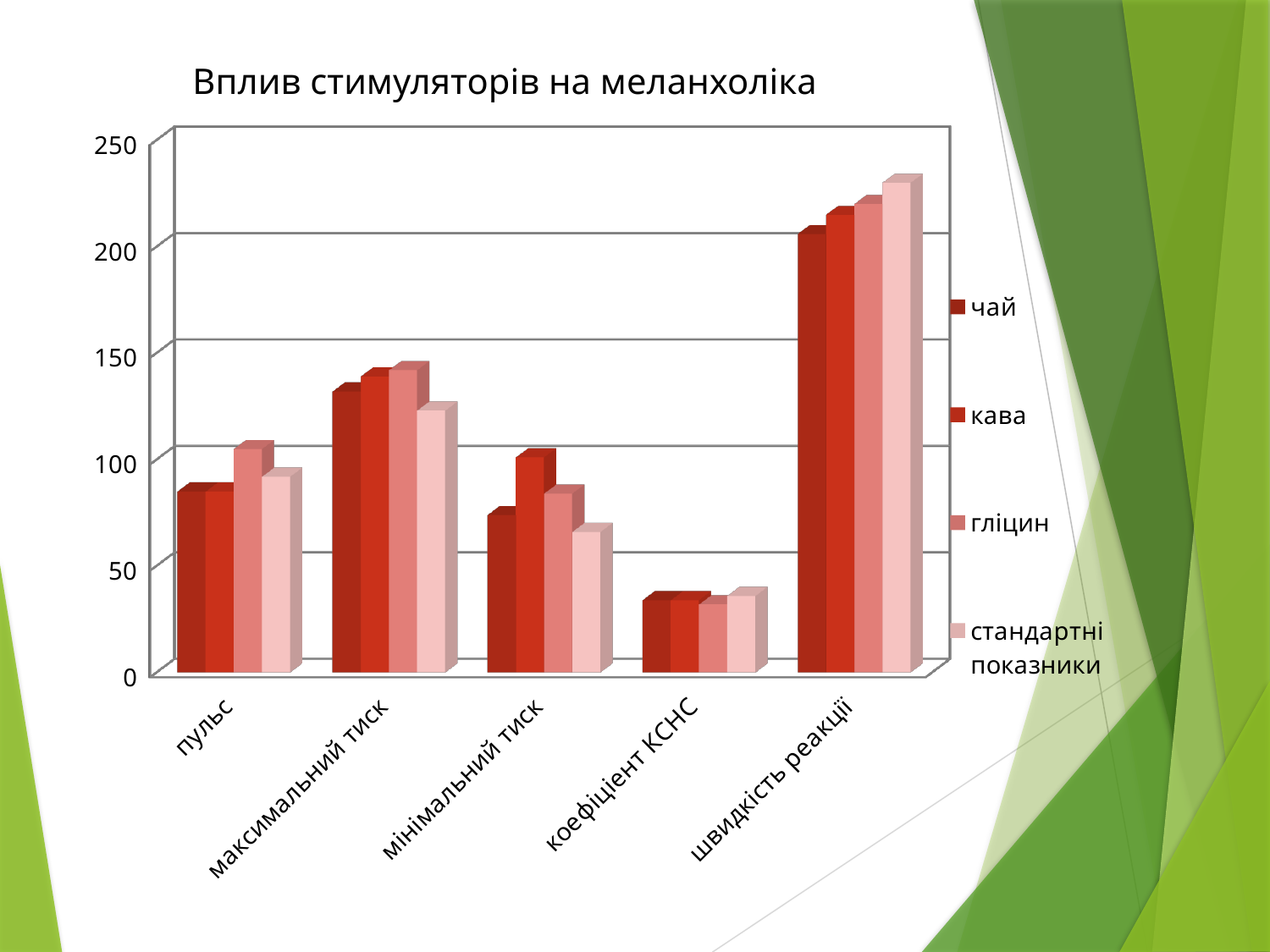
Which category has the highest bars overall? швидкість реакції Is the value for кава in максимальний тиск greater or less than 100? greater Is the value for чай in коефіцієнт КСНС greater or less than 50? less In the мінімальний тиск category, which is larger: чай or кава? кава Which category has the lowest bars overall? коефіцієнт КСНС Is the value for стандартні показники in мінімальний тиск greater or less than 100? less How many categories are shown on the x axis? 5 What is the title of the chart? Вплив стимуляторів на меланхоліка Which series has the highest bar in the швидкість реакції category? стандартні показники How many series does the legend list? 4 What kind of chart is shown on the slide? bar chart